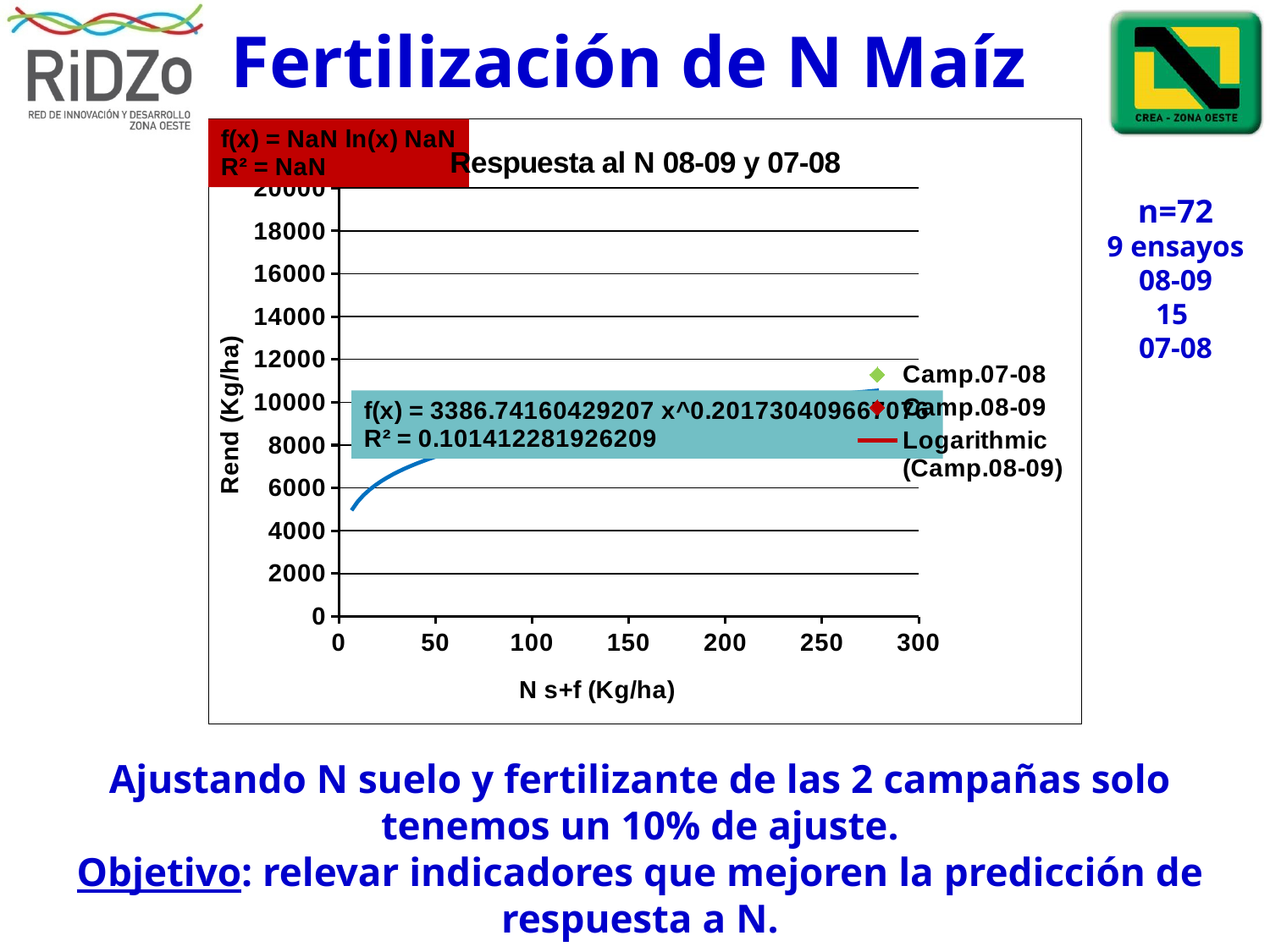
Which series does the 'Logarithmic' trendline in the legend belong to? Camp.08-09 Is the fitted trendline value at N s+f = 50 greater or less than 8000? less What kind of chart is shown on the slide? scatter chart What R² value is printed in the blue equation box on the chart? 0.101412281926209 What is the title of the chart? Respuesta al N 08-09 y 07-08 How many entries does the chart legend list? 3 Does the fitted trendline rise or fall as N s+f increases? rises Is the fitted trendline value at its starting point near N s+f = 0 greater or less than 4000? greater